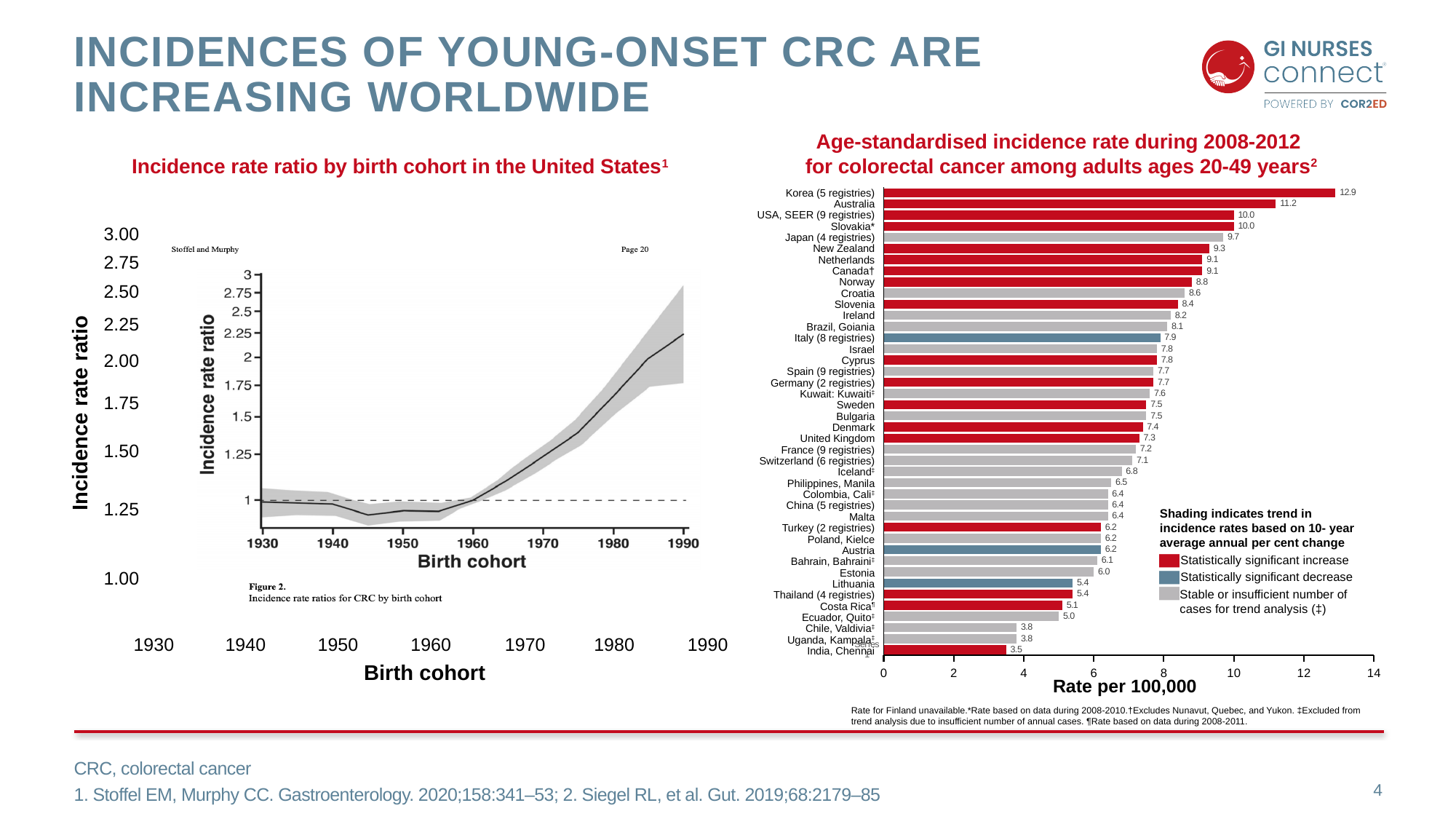
In the age-standardised incidence rate chart on the right, what is the difference between the rates for Korea (5 registries) and Australia? 1.7 In the age-standardised incidence rate chart on the right, what is the rate per 100,000 for Korea (5 registries)? 12.9 In the age-standardised incidence rate chart on the right, how many countries or registries are plotted? 42 In the age-standardised incidence rate chart on the right, what is the rate per 100,000 for the United Kingdom? 7.3 In the age-standardised incidence rate chart on the right, which country or registry has the highest rate? Korea (5 registries) In the age-standardised incidence rate chart on the right, which has the higher rate, Netherlands or Norway? Netherlands What kind of chart is the incidence rate ratio by birth cohort chart on the left? Line chart In the age-standardised incidence rate chart on the right, which country or registry has the lowest rate? India, Chennai In the age-standardised incidence rate chart on the right, what is the rate per 100,000 for Australia? 11.2 In the incidence rate ratio by birth cohort chart on the left, does the incidence rate ratio rise or fall from the 1960 birth cohort to the 1990 birth cohort? Rise What kind of chart is the age-standardised incidence rate chart on the right? Bar chart In the incidence rate ratio by birth cohort chart on the left, is the incidence rate ratio for the 1990 birth cohort greater or less than 2.00? greater